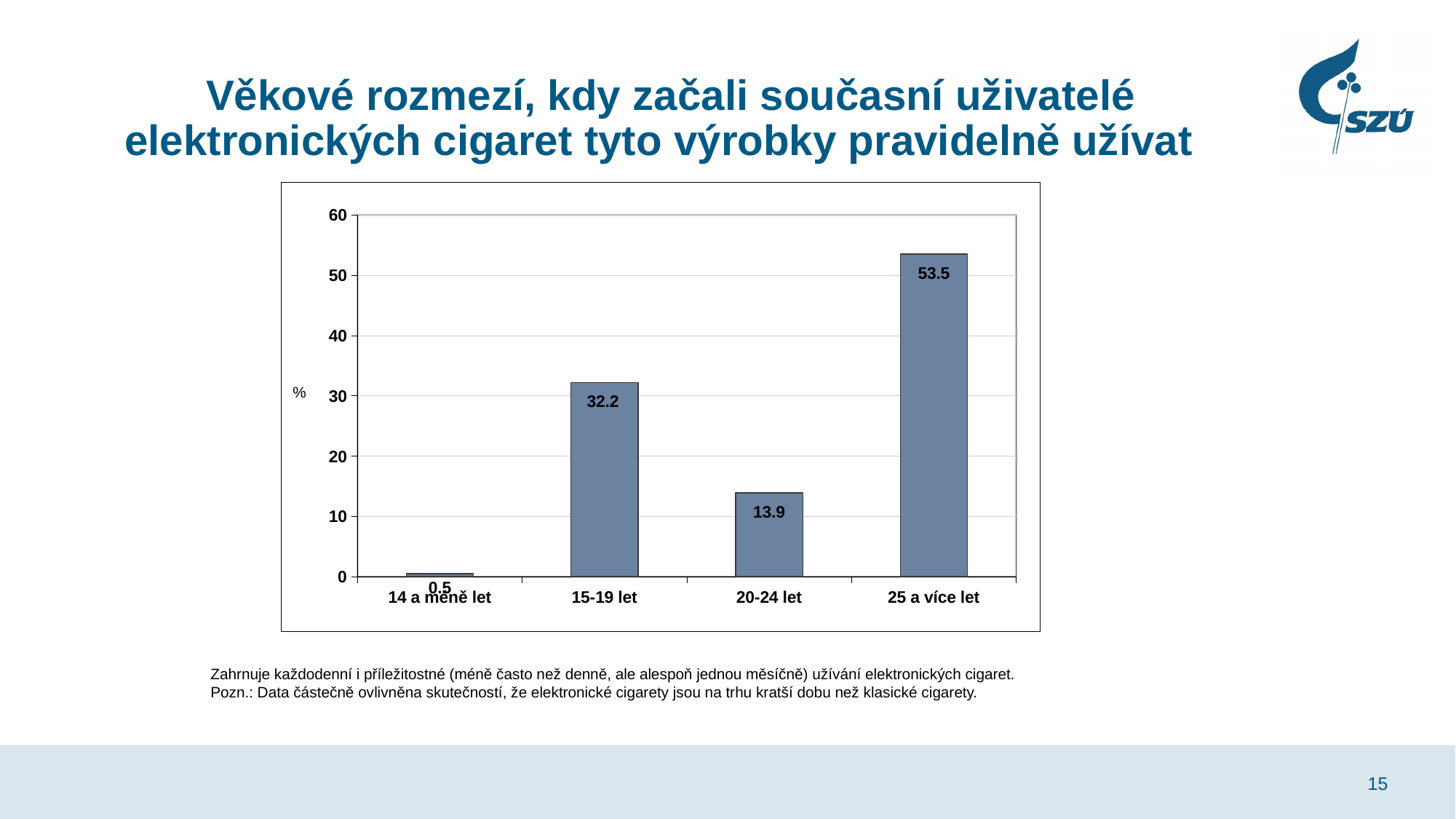
What is the value for the 15-19 let category? 32.2 What is the difference between the values for 25 a více let and 15-19 let? 21.3 What is the value for the 25 a více let category? 53.5 What unit is shown on the y axis label? % Which age category has the lowest value? 14 a méně let Is the value for 25 a více let greater or less than 50? greater What is the value for the 14 a méně let category? 0.5 What kind of chart is shown on the slide? bar chart What is the value for the 20-24 let category? 13.9 How many age categories are shown on the x axis? 4 Which is larger, the value for 15-19 let or the value for 20-24 let? 15-19 let Which age category has the highest value? 25 a více let